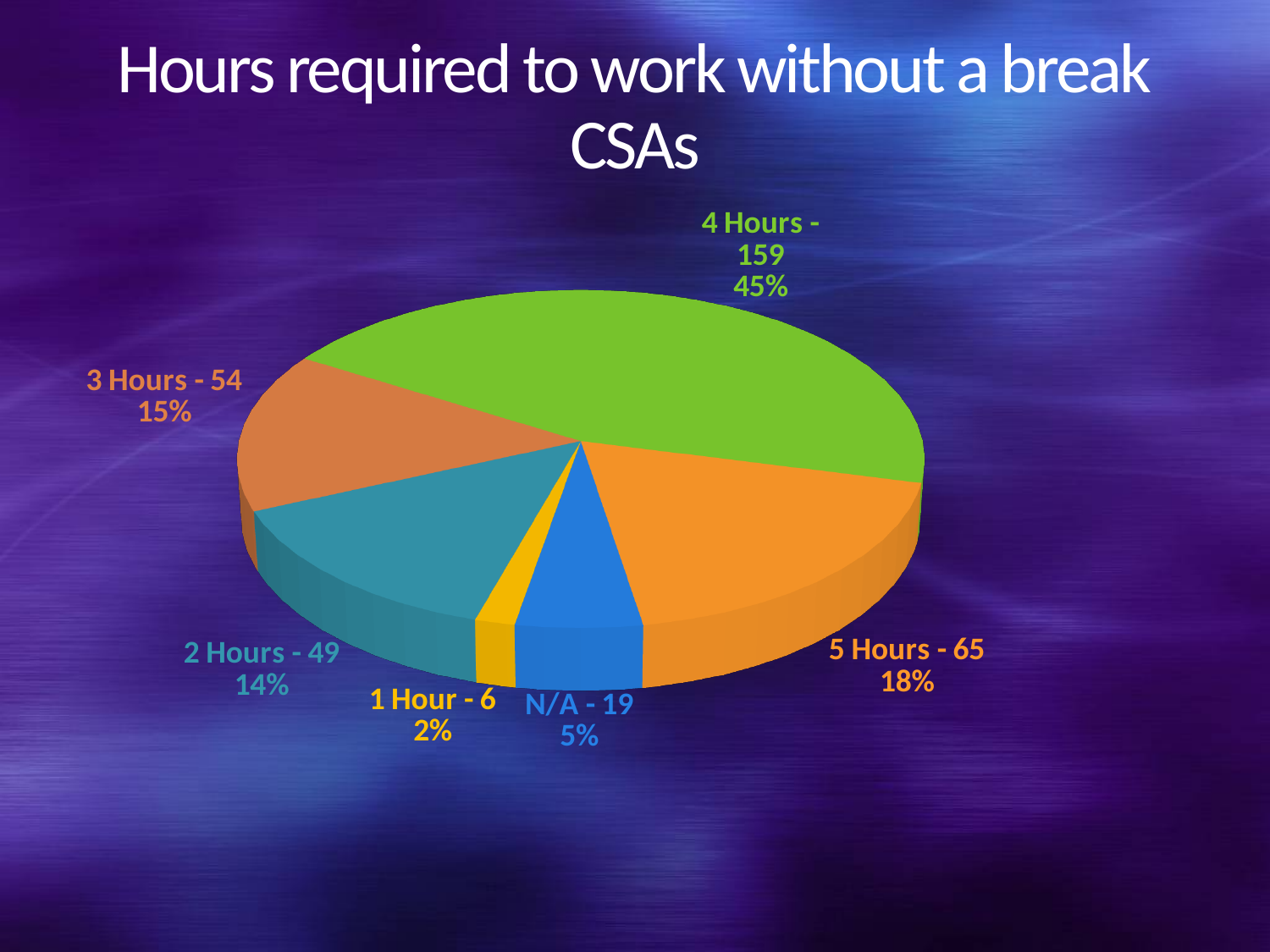
Which category has the smallest slice of the pie? 1 Hour What is the title of the chart? Hours required to work without a break CSAs What kind of chart is shown on the slide? Pie chart Which is larger, the count for 3 Hours or the count for 2 Hours? 3 Hours What colour is the 4 Hours slice? Green How many CSAs reported 4 Hours as the hours required to work without a break? 159 Which category has the largest slice of the pie? 4 Hours What is the count for the 2 Hours category? 49 What is the difference between the counts for 5 Hours and 3 Hours? 11 What percentage of the pie does the 5 Hours slice represent? 18% What percentage of the pie does the N/A slice represent? 5% How many categories are shown in the pie chart? 6